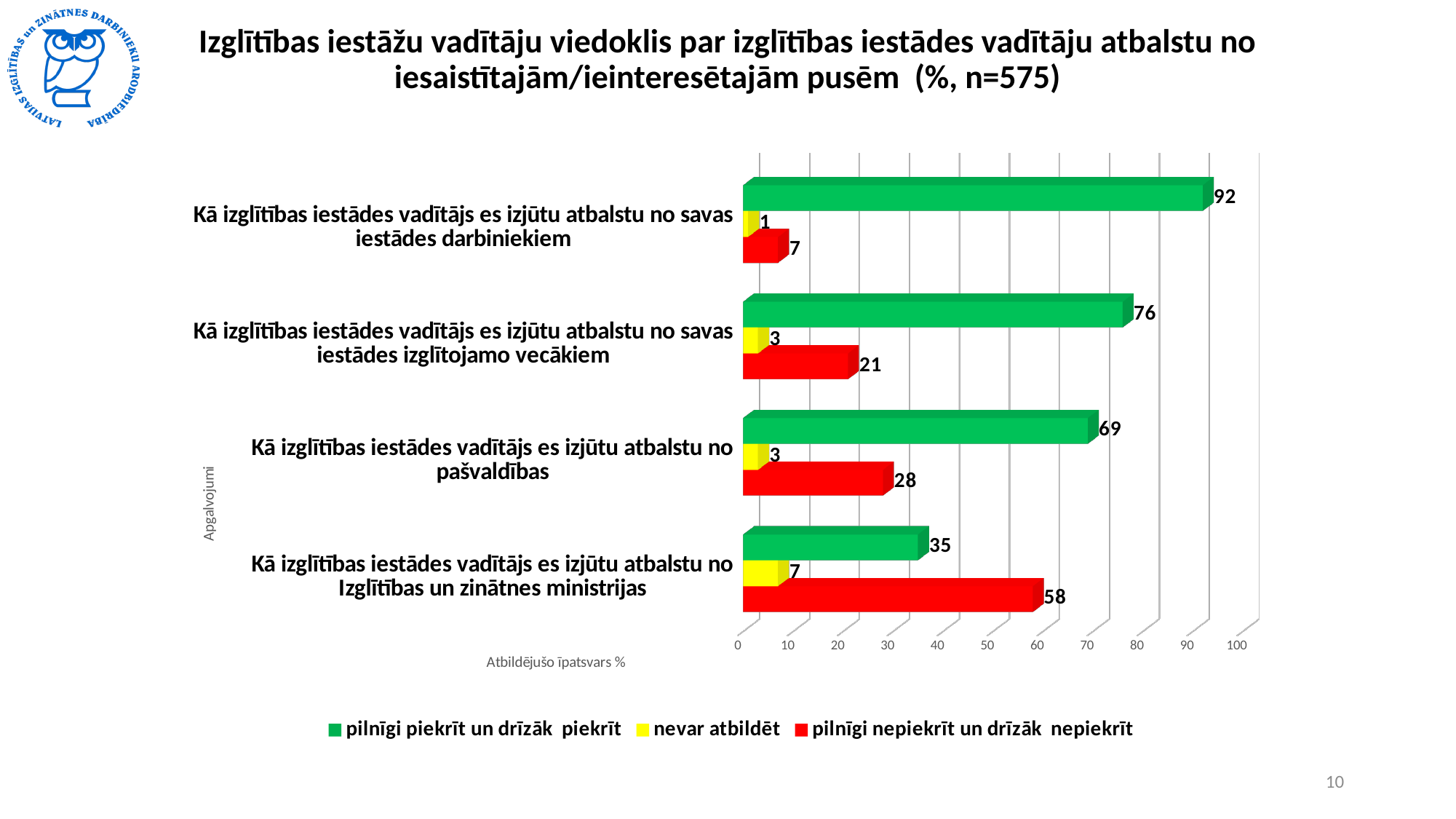
How many series does the legend list? 3 What is the value of 'pilnīgi nepiekrīt un drīzāk nepiekrīt' for the statement about support from the Izglītības un zinātnes ministrija? 58 What is the difference between the 'pilnīgi piekrīt un drīzāk piekrīt' values for support from the institution's employees and support from the pašvaldība? 23 What type of chart is shown on the slide? bar chart Which is larger for the statement about support from the Izglītības un zinātnes ministrija: the 'pilnīgi piekrīt un drīzāk piekrīt' value or the 'pilnīgi nepiekrīt un drīzāk nepiekrīt' value? pilnīgi nepiekrīt un drīzāk nepiekrīt What is the value of 'pilnīgi piekrīt un drīzāk piekrīt' for the statement about support from the institution's employees (savas iestādes darbiniekiem)? 92 For which statement is the 'pilnīgi nepiekrīt un drīzāk nepiekrīt' value the highest? Kā izglītības iestādes vadītājs es izjūtu atbalstu no Izglītības un zinātnes ministrijas What is the value of 'nevar atbildēt' for the statement about support from the pašvaldība? 3 For which statement is the 'pilnīgi piekrīt un drīzāk piekrīt' value the lowest? Kā izglītības iestādes vadītājs es izjūtu atbalstu no Izglītības un zinātnes ministrijas How many statements (categories) are plotted on the chart? 4 Which colour represents the 'nevar atbildēt' series in the chart? yellow What is the value of 'pilnīgi nepiekrīt un drīzāk nepiekrīt' for the statement about support from the students' parents (izglītojamo vecākiem)? 21